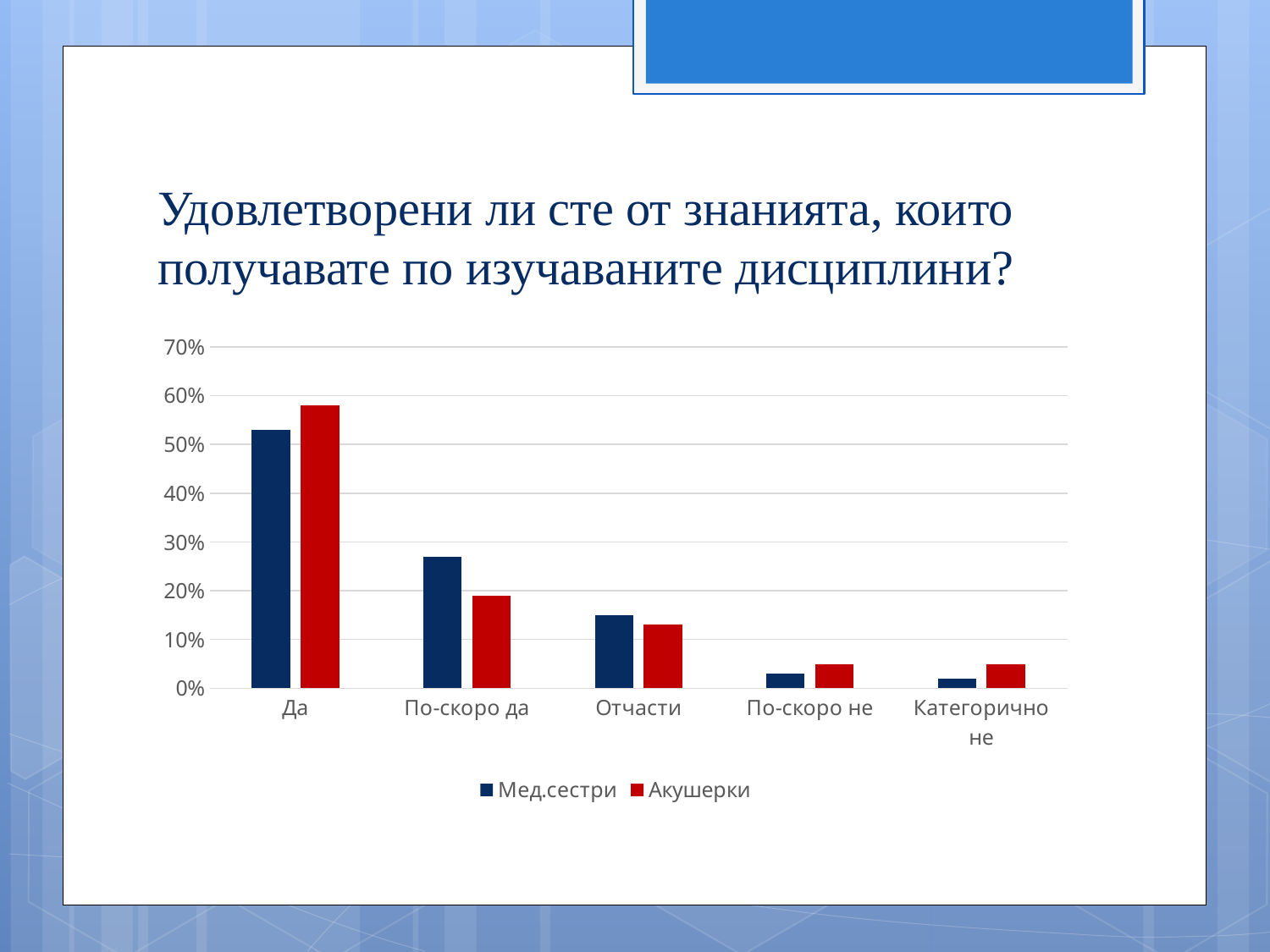
How many series does the legend list? 2 How many answer categories are shown on the x axis? 5 Is the value for Акушерки in the category Да greater or less than 60%? less For the category По-скоро да, which series has the larger value, Мед.сестри or Акушерки? Мед.сестри What kind of chart is shown on the slide? bar chart Is the value for Мед.сестри in the category По-скоро да greater or less than 20%? greater Which category has the highest value for Мед.сестри? Да Which category has the highest value for Акушерки? Да For the category Да, which series has the larger value, Мед.сестри or Акушерки? Акушерки Do the values for Мед.сестри rise or fall moving from Да to Категорично не along the x axis? fall Is the value for Мед.сестри in the category Да greater or less than 50%? greater